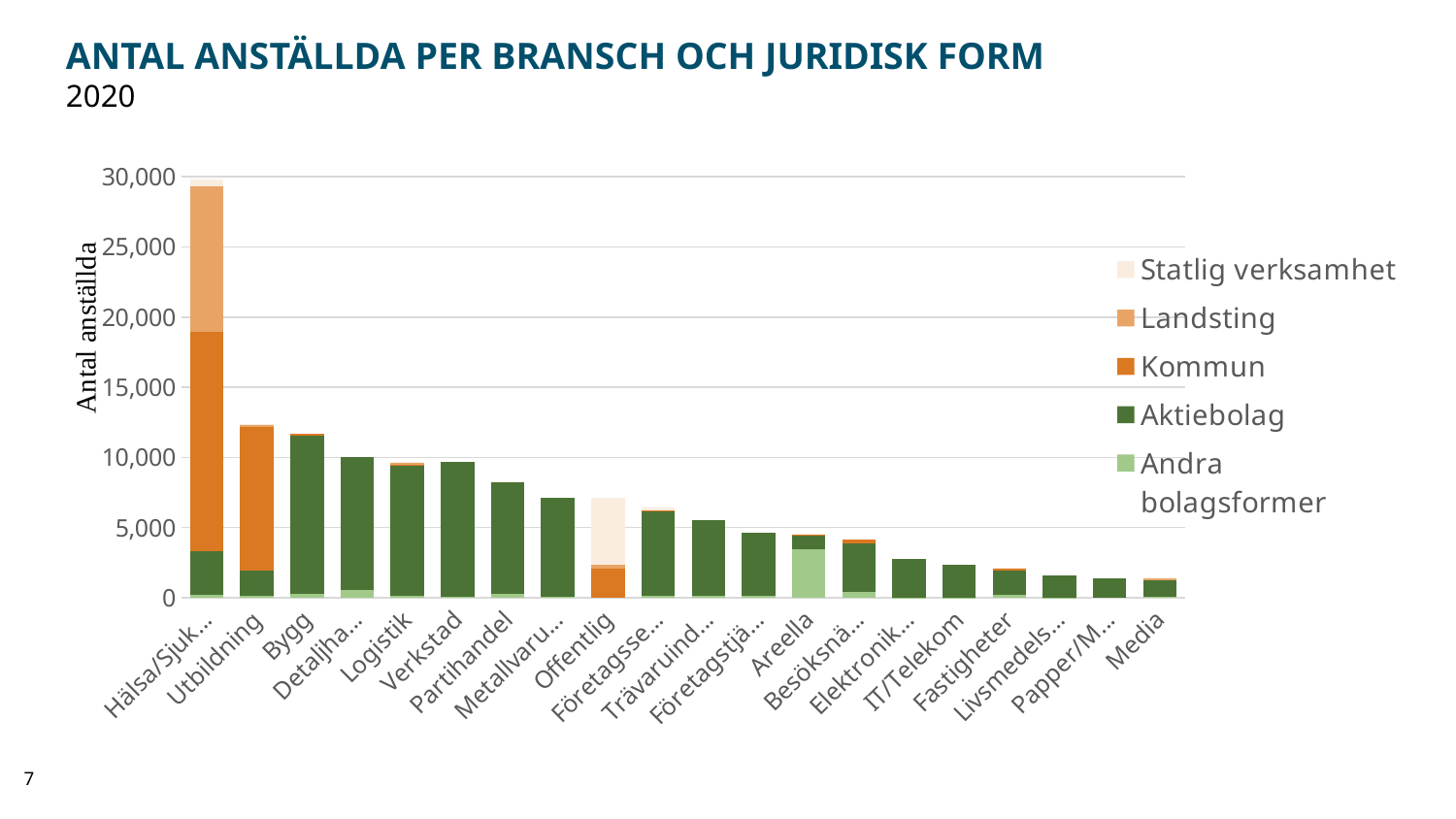
What kind of chart is shown on the slide? Stacked bar chart Is the total value for Verkstad greater or less than 10,000? less Is the total value for IT/Telekom greater or less than 5,000? less Do the total bar heights generally rise or fall from left to right along the x axis? Fall Is the total value for Utbildning greater or less than 10,000? greater Which series makes up most of the Offentlig bar? Statlig verksamhet What is the title of the chart? ANTAL ANSTÄLLDA PER BRANSCH OCH JURIDISK FORM 2020 How many series does the legend list? 5 Which category has the highest total number of employees? Hälsa/Sjuk... (the leftmost bar) How many categories (branches) are shown on the x axis? 20 Which has a larger total, Verkstad or Partihandel? Verkstad